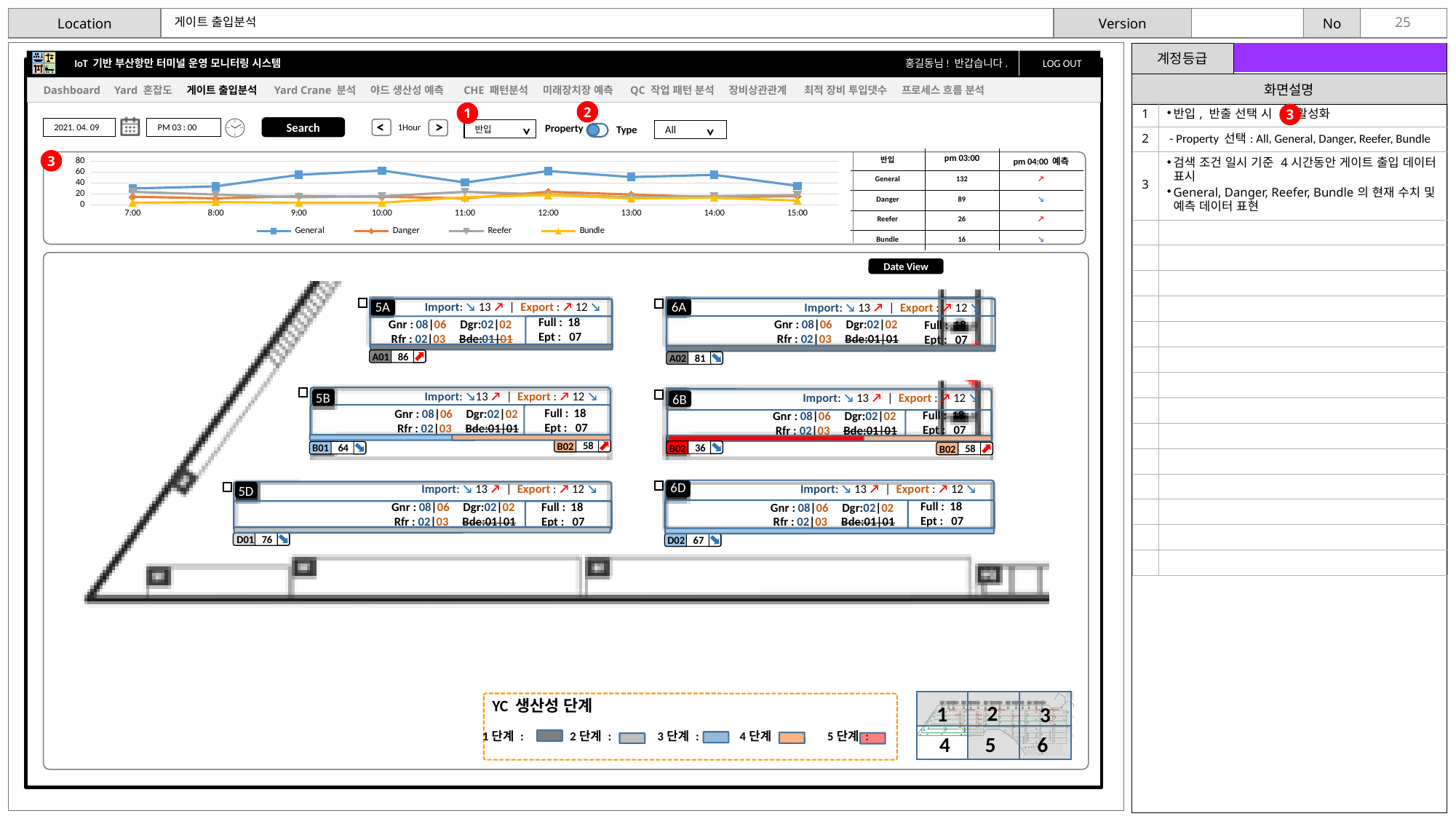
At 12:00, which is larger, the value for General or the value for Bundle? General How many series does the legend of the line chart list? 4 Does the General series rise or fall from 7:00 to 10:00? rise Which series has the highest values across the line chart? General What are the series names in the legend of the line chart? General, Danger, Reefer, Bundle What kind of chart is shown at the top of the slide? line chart Is the value for Bundle at 7:00 greater or less than 20? less What is the highest tick value shown on the y axis of the line chart? 80 How many time points are shown along the x axis of the line chart? 9 Is the value for General at 12:00 greater or less than 40? greater What is the first time label on the x axis of the line chart? 7:00 Is the value for General at 7:00 greater or less than 40? less